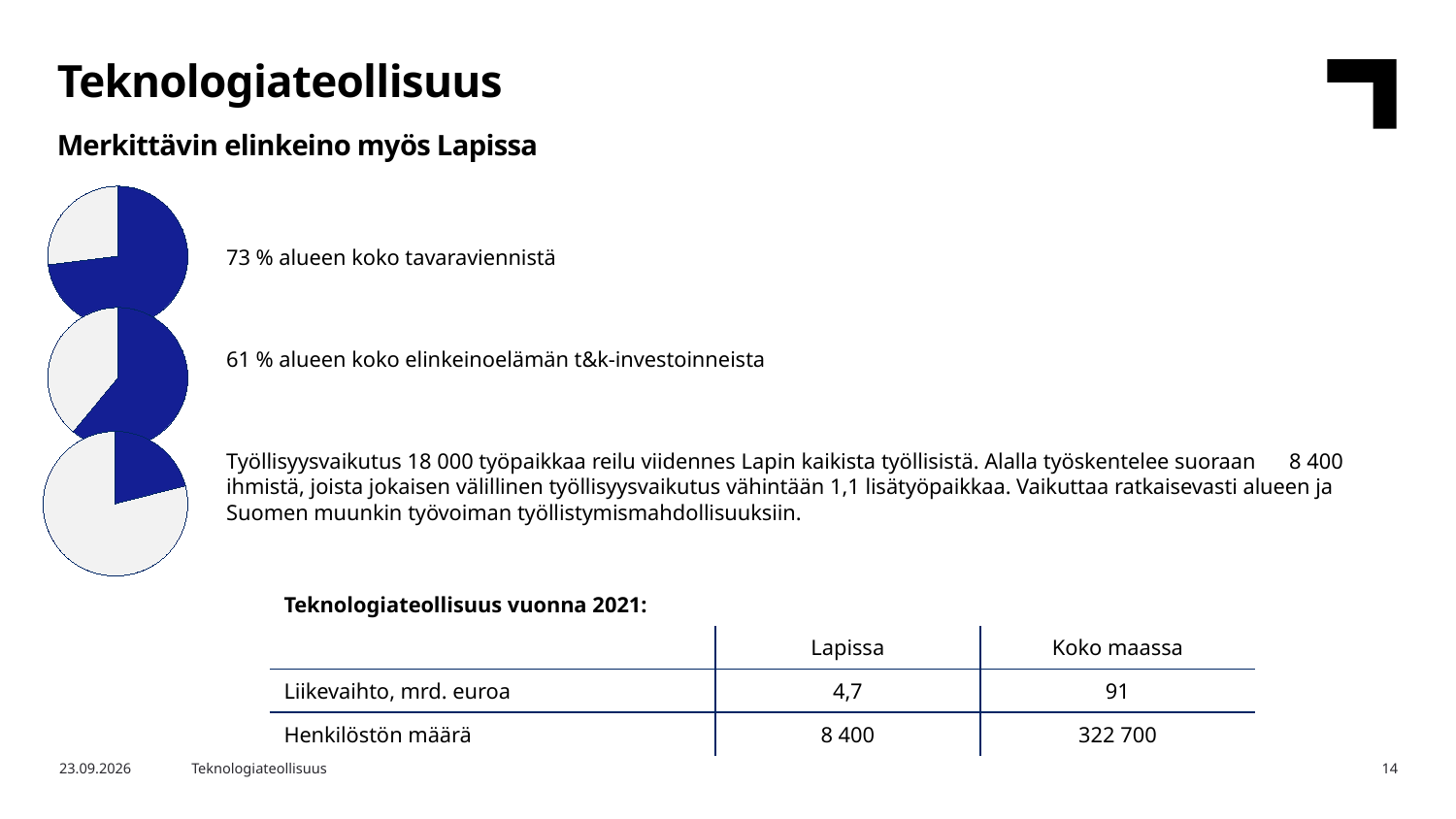
Is the blue slice larger in the middle pie chart or in the bottom pie chart? Middle pie chart What colour is used for the highlighted slice in each pie chart? Dark blue How many pie charts are on the slide? 3 Is the blue slice larger in the top pie chart or in the middle pie chart? Top pie chart Is the blue slice in the bottom pie chart greater or less than 50% of the pie? less What kind of charts are shown on the left side of the slide? Pie charts Is the blue slice in the top pie chart greater or less than 50% of the pie? greater Which pie chart has the largest blue slice: the top, middle or bottom one? Top In the top pie chart, what share of the region's total goods exports does the blue slice represent? 73 % Which pie chart has the smallest blue slice: the top, middle or bottom one? Bottom How many slices does each pie chart have? 2 In the middle pie chart, what share of the region's business R&D investments does the blue slice represent? 61 %